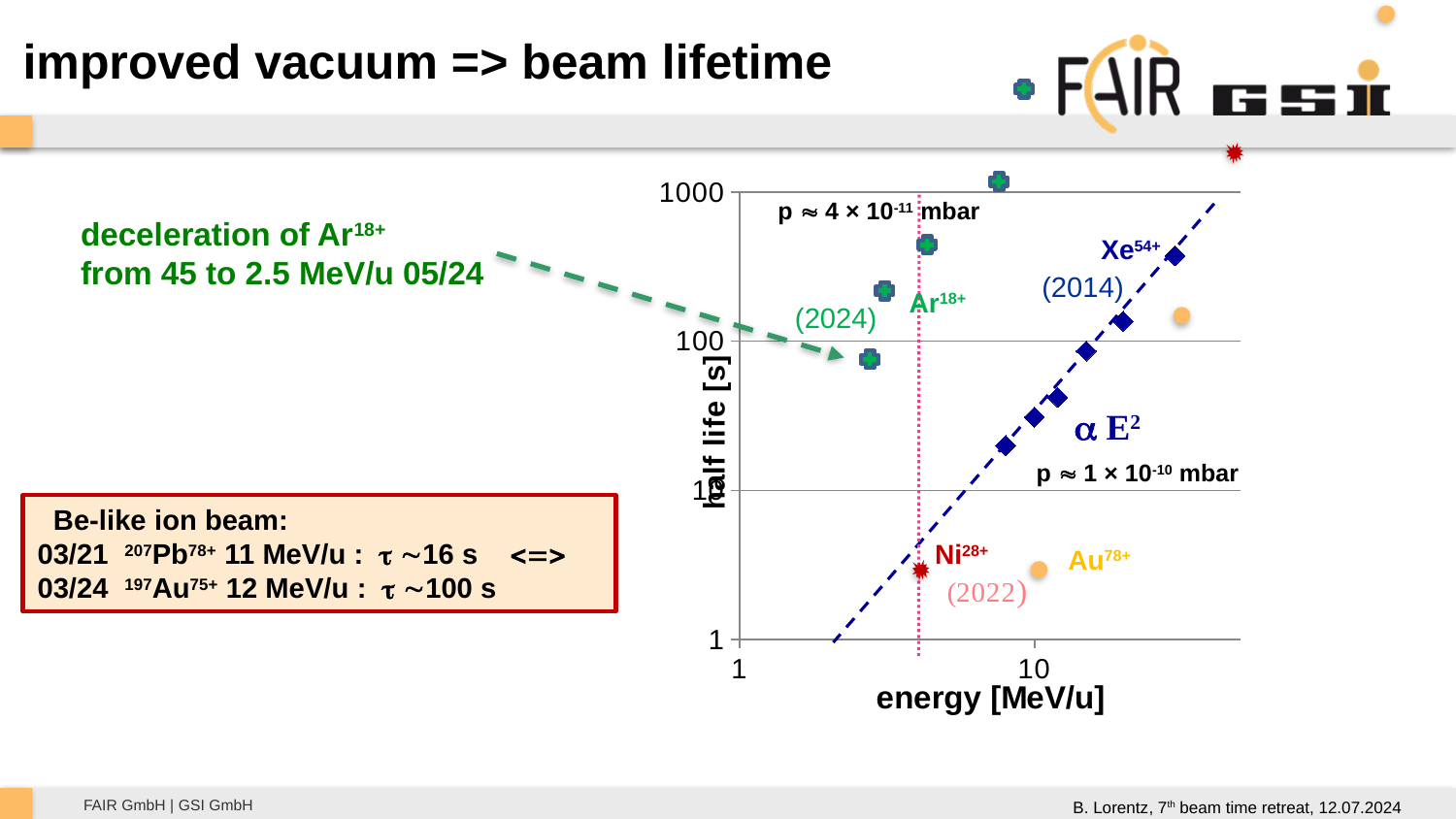
Is the half life of the Ni28+ point greater or less than 10 s? less Is the half life of the highest Xe54+ point greater or less than 100 s? greater What is the title of the slide containing the chart? improved vacuum => beam lifetime What quantity is plotted on the x axis of the chart? energy [MeV/u] Is the half life of the Au78+ point greater or less than 10 s? less What kind of chart is shown on the slide? scatter chart At an energy of about 4 MeV/u, which ion has the longer half life, Ar18+ or Ni28+? Ar18+ How many green Ar18+ data points are plotted on the chart? 4 Does the half life of the Xe54+ points rise or fall as energy increases? rise